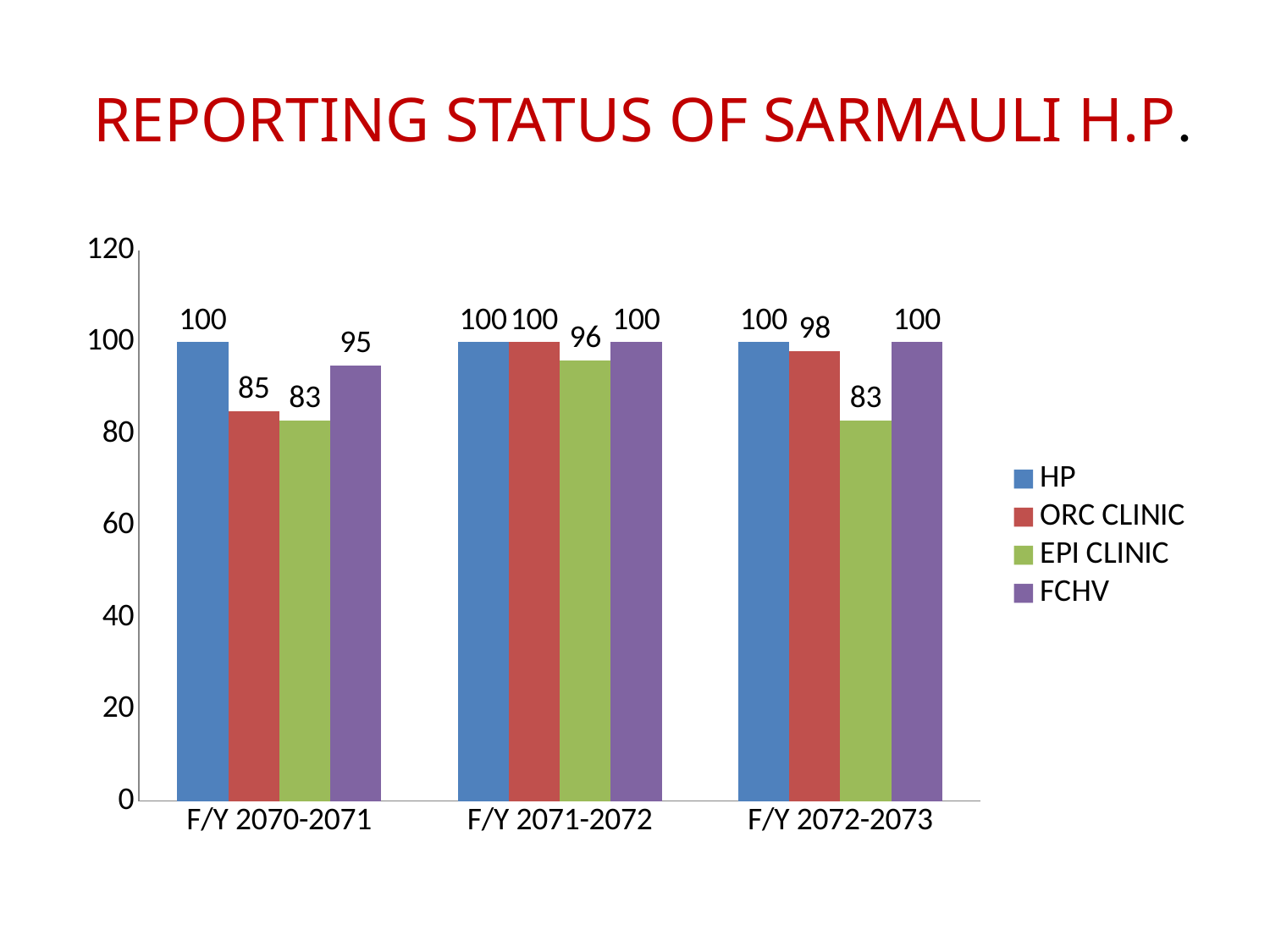
What is the value for FCHV in F/Y 2070-2071? 95 Which series has the lowest value in F/Y 2072-2073? EPI CLINIC What is the value for EPI CLINIC in F/Y 2071-2072? 96 What is the title of the chart? REPORTING STATUS OF SARMAULI H.P. Which is larger in F/Y 2070-2071, the ORC CLINIC value or the FCHV value? FCHV Which series has the lowest value in F/Y 2070-2071? EPI CLINIC How many series does the legend list? 4 What kind of chart is shown on the slide? Bar chart What is the value for ORC CLINIC in F/Y 2072-2073? 98 What is the difference between the HP value and the EPI CLINIC value in F/Y 2072-2073? 17 How many fiscal year categories are shown on the x axis? 3 What is the value for ORC CLINIC in F/Y 2070-2071? 85